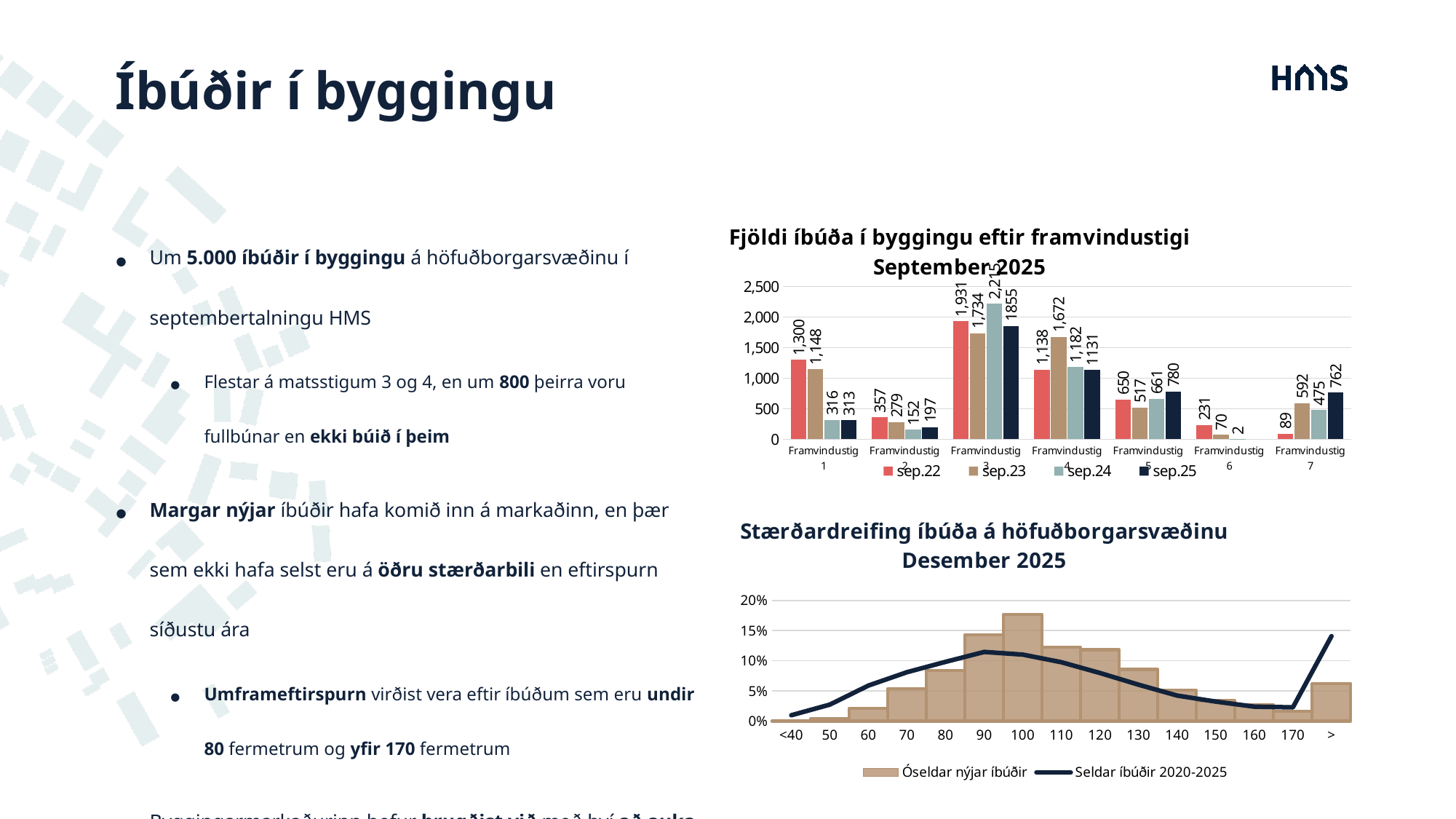
In the chart 'Fjöldi íbúða í byggingu eftir framvindustigi September 2025', which Framvindustig has the highest sep.25 value? Framvindustig 3 In the chart 'Fjöldi íbúða í byggingu eftir framvindustigi September 2025', what is the sep.23 value for Framvindustig 7? 592 What kind of chart is 'Fjöldi íbúða í byggingu eftir framvindustigi September 2025'? Bar chart How many Framvindustig categories are shown on the x axis of the chart 'Fjöldi íbúða í byggingu eftir framvindustigi September 2025'? 7 In the chart 'Fjöldi íbúða í byggingu eftir framvindustigi September 2025', what is the sep.22 value for Framvindustig 1? 1,300 How many series does the legend of the chart 'Fjöldi íbúða í byggingu eftir framvindustigi September 2025' list? 4 In the chart 'Fjöldi íbúða í byggingu eftir framvindustigi September 2025', what is the sep.25 value for Framvindustig 5? 780 In the chart 'Fjöldi íbúða í byggingu eftir framvindustigi September 2025', which Framvindustig has the lowest sep.22 value? Framvindustig 7 In the chart 'Fjöldi íbúða í byggingu eftir framvindustigi September 2025', what is the difference between the sep.22 and sep.25 values for Framvindustig 1? 987 In the chart 'Stærðardreifing íbúða á höfuðborgarsvæðinu Desember 2025', is the Óseldar nýjar íbúðir value for 100 greater or less than 15%? greater In the chart 'Fjöldi íbúða í byggingu eftir framvindustigi September 2025', for Framvindustig 4, which is larger: sep.23 or sep.24? sep.23 In the chart 'Stærðardreifing íbúða á höfuðborgarsvæðinu Desember 2025', which size category has the highest Óseldar nýjar íbúðir bar? 100